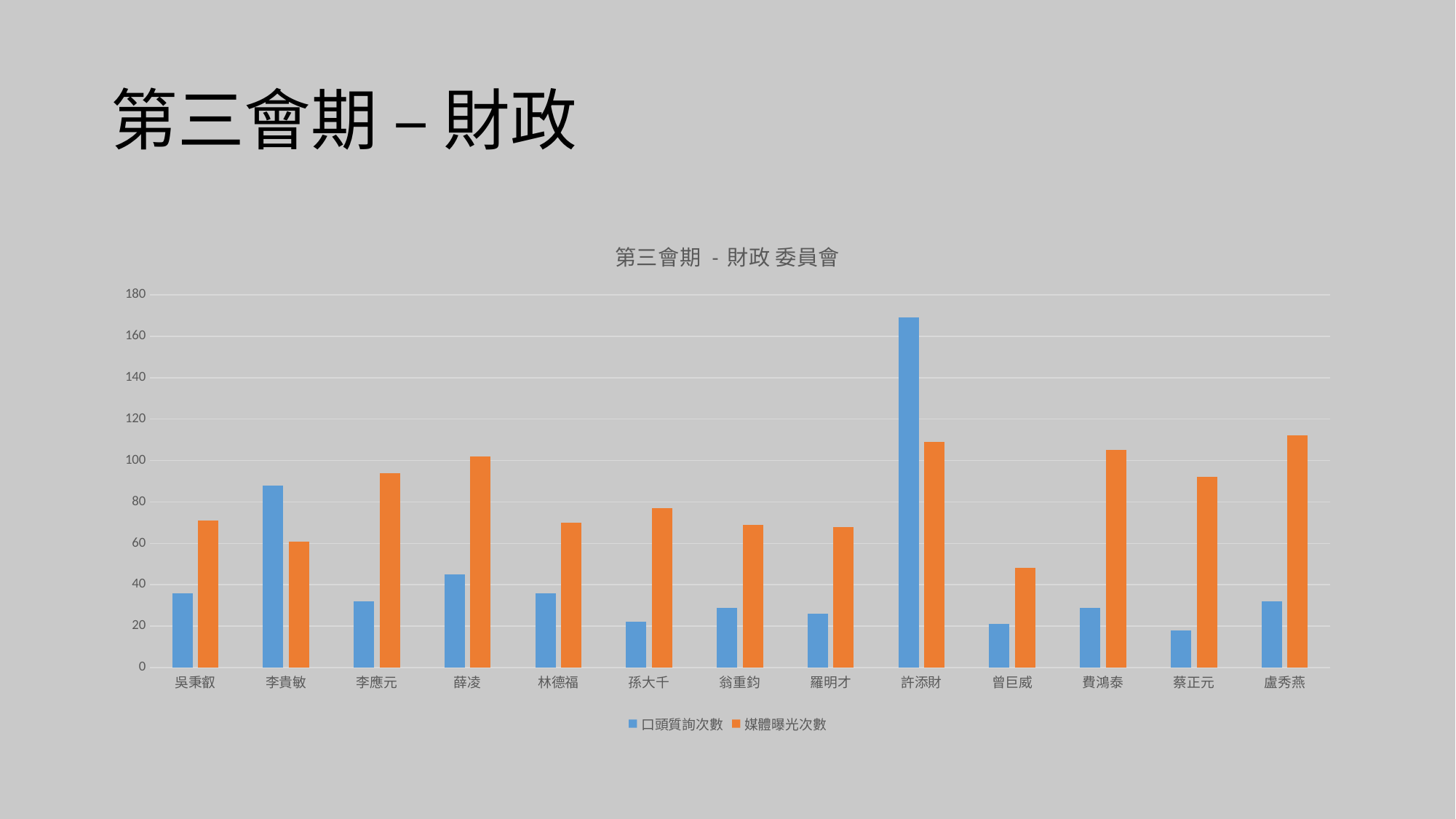
Which has the larger 媒體曝光次數 value: 費鴻泰 or 蔡正元? 費鴻泰 How many legislators (categories) are shown on the x axis of the chart? 13 Which legislator has the highest 口頭質詢次數 value? 許添財 Is the 口頭質詢次數 value for 許添財 greater or less than 160? greater Which series is shown in orange in the chart? 媒體曝光次數 What is the title of the chart? 第三會期 - 財政 委員會 Which legislator has the lowest 媒體曝光次數 value? 曾巨威 For 李貴敏, which is larger: 口頭質詢次數 or 媒體曝光次數? 口頭質詢次數 What kind of chart is shown on the slide? bar chart How many series does the chart's legend list? 2